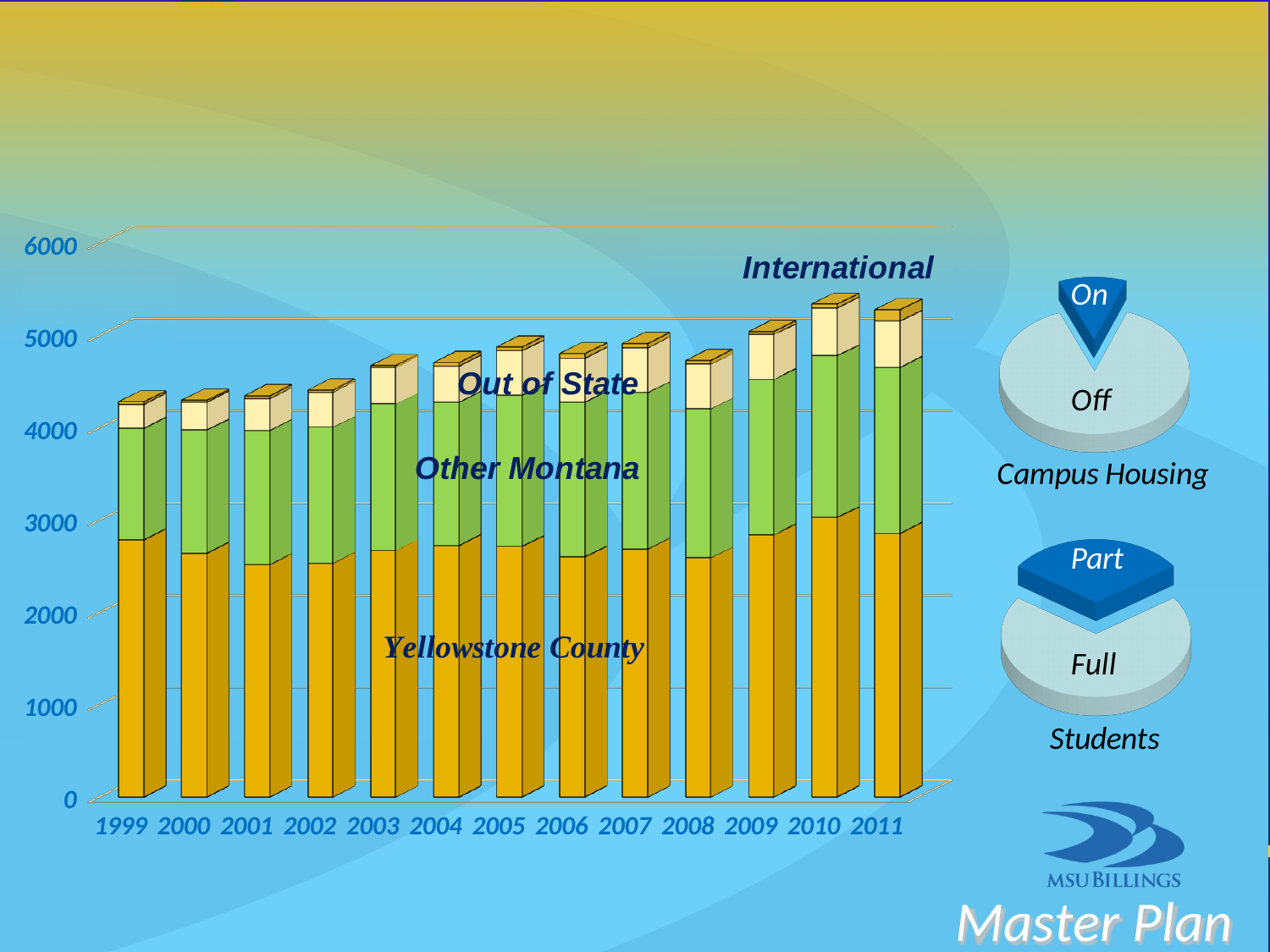
In the stacked bar chart, is the total for 1999 greater or less than 5000? less How many years are shown along the x axis of the stacked bar chart? 13 In the stacked bar chart, do the total bars generally rise or fall from 1999 to 2011? rise What kind of chart is the main chart on the left of the slide? stacked bar chart In the stacked bar chart, is the Yellowstone County value for 2001 greater or less than 3000? less How many series are stacked in each bar of the stacked bar chart? 4 In the stacked bar chart, is the total for 2010 greater or less than 5000? greater In the stacked bar chart, which year has the tallest total bar? 2010 In the stacked bar chart, which series forms the bottom segment of each bar? Yellowstone County In the stacked bar chart, which total bar is taller, 2008 or 2010? 2010 In the Campus Housing pie chart, which slice is larger, On or Off? Off